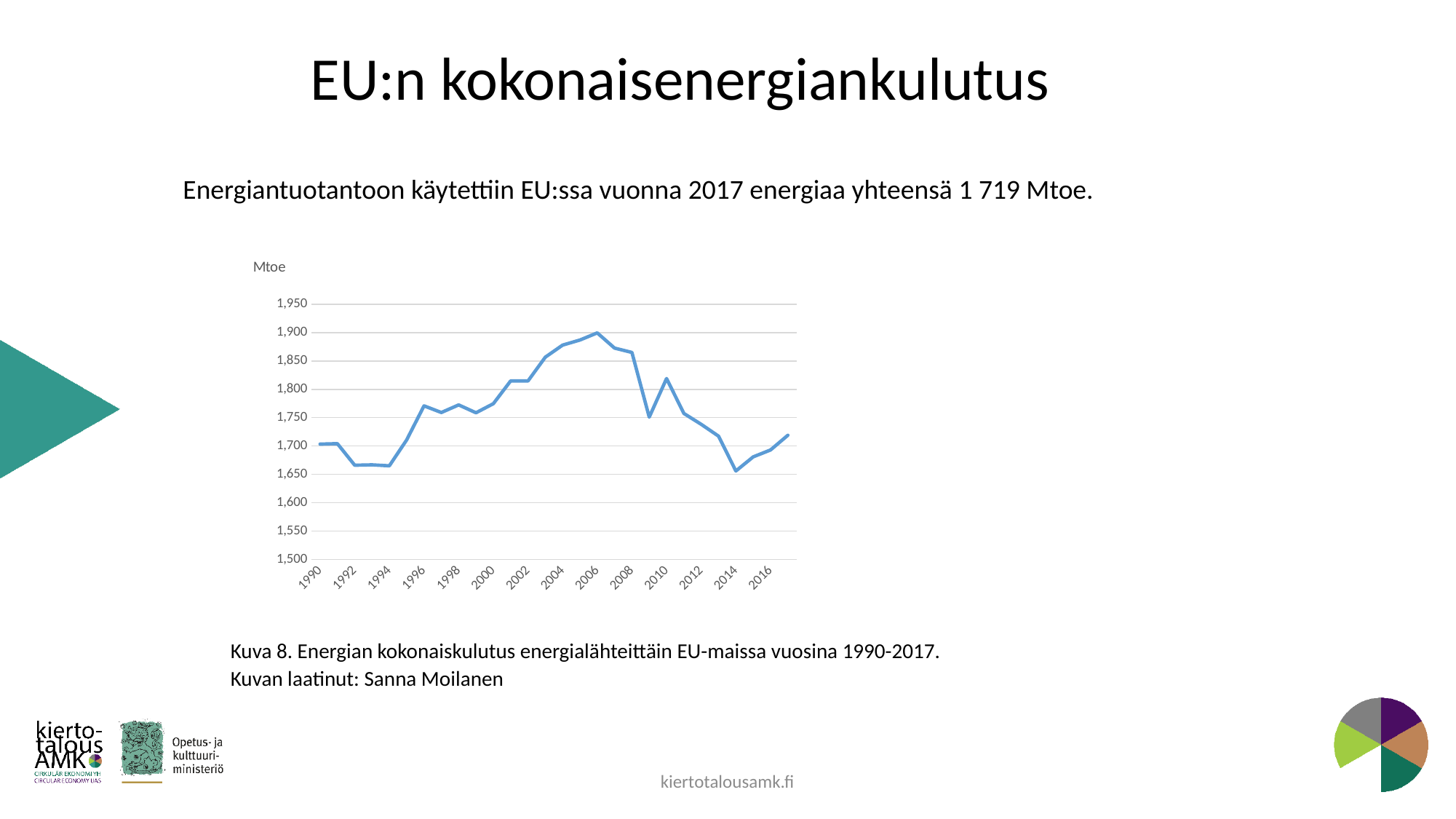
Is the value for 2006 greater or less than 1,850? greater What kind of chart is shown on the slide? line chart Is the value for 2014 greater or less than 1,700? less In which year does the line reach its highest value? 2006 Which year has the larger value, 2004 or 2014? 2004 Is the value for 2009 greater or less than 1,800? less Does the line rise or fall between 2010 and 2014? fall What is the title of the slide containing the chart? EU:n kokonaisenergiankulutus How many year labels are shown on the x axis? 14 According to the slide, what was the EU's total energy consumption in 2017? 1 719 Mtoe What unit is shown on the y axis of the chart? Mtoe